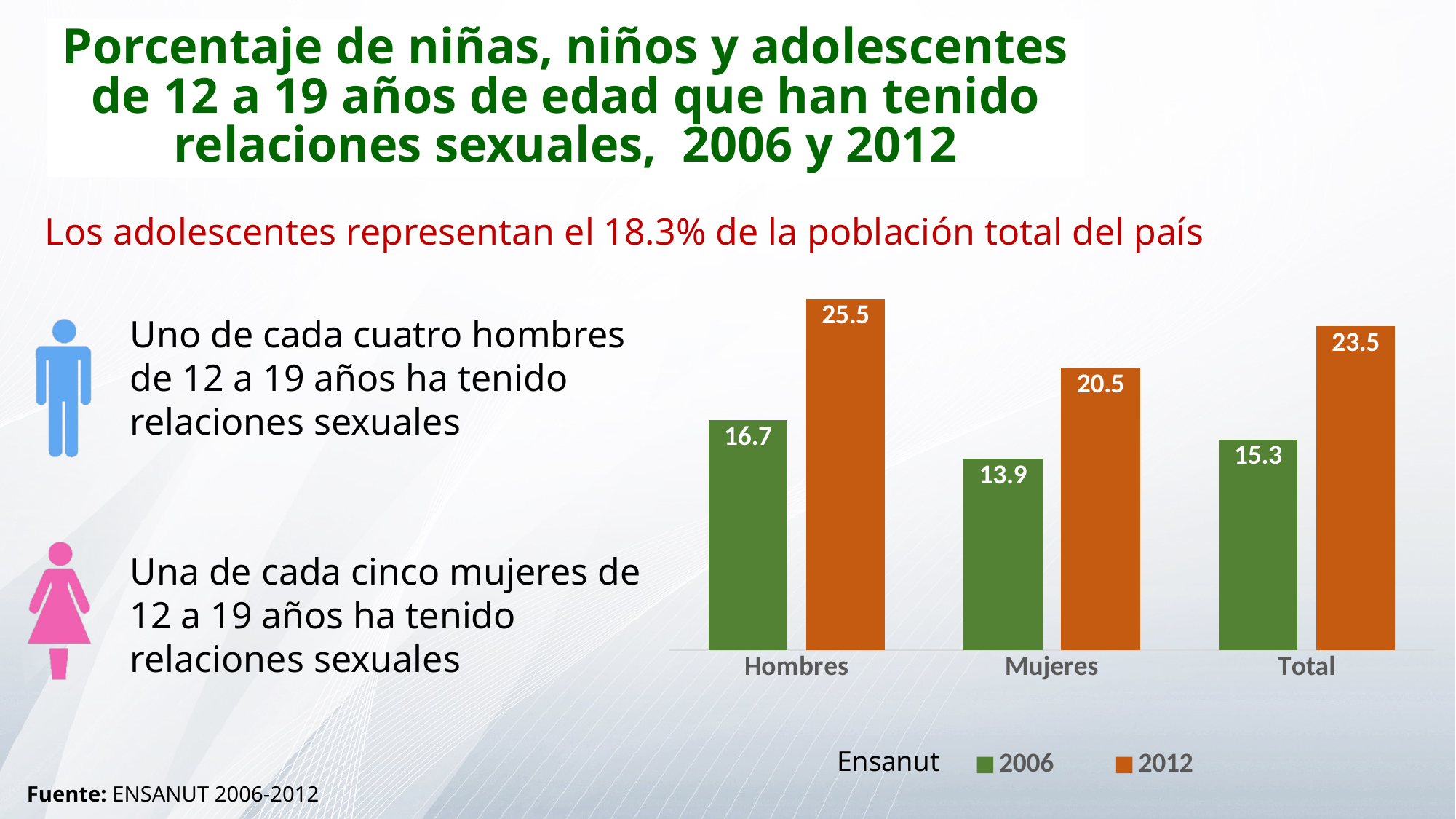
How many series does the legend list? 2 What is the difference between the 2012 and 2006 values for Total? 8.2 How many categories are shown on the x axis? 3 Which is larger: the 2006 value for Hombres or the 2006 value for Total? Hombres Which colour represents the 2012 series in the legend? Orange Which category has the highest value in the 2012 series? Hombres What is the value for Total in the 2012 series? 23.5 What kind of chart is shown on the slide? Bar chart What is the value for Hombres in the 2012 series? 25.5 What is the difference between the 2012 and 2006 values for Hombres? 8.8 What is the value for Mujeres in the 2006 series? 13.9 Which category has the lowest value in the 2006 series? Mujeres